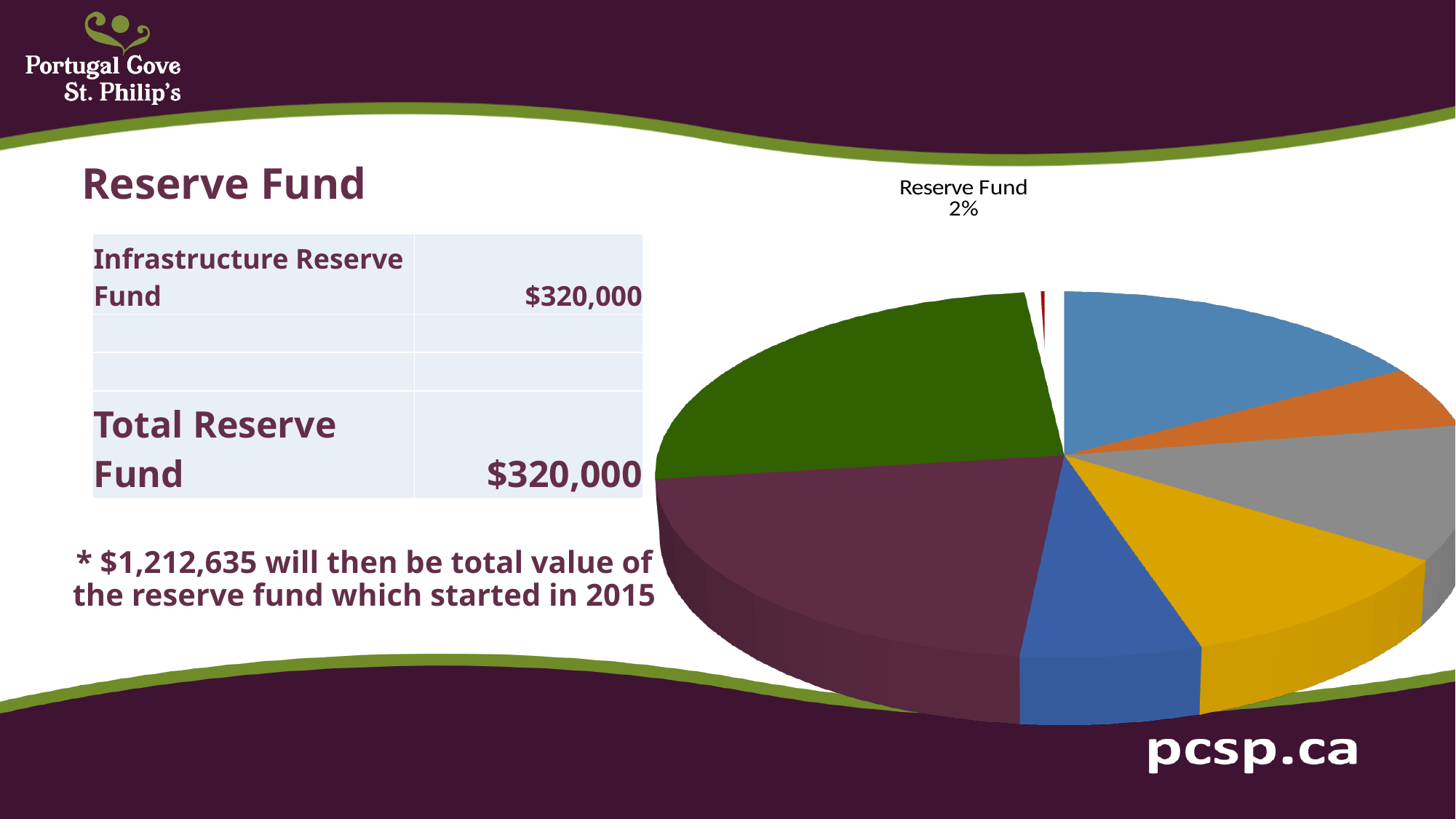
How many slices does the pie chart have? 8 Is the Reserve Fund slice the largest or the smallest slice of the pie? smallest Which slice of the pie chart is labeled with a percentage? Reserve Fund What share of the pie does the Reserve Fund slice represent? 2% What colour is the Reserve Fund slice in the pie chart? red Is the share of the Reserve Fund slice greater or less than 10%? less What kind of chart is shown on the slide? pie chart